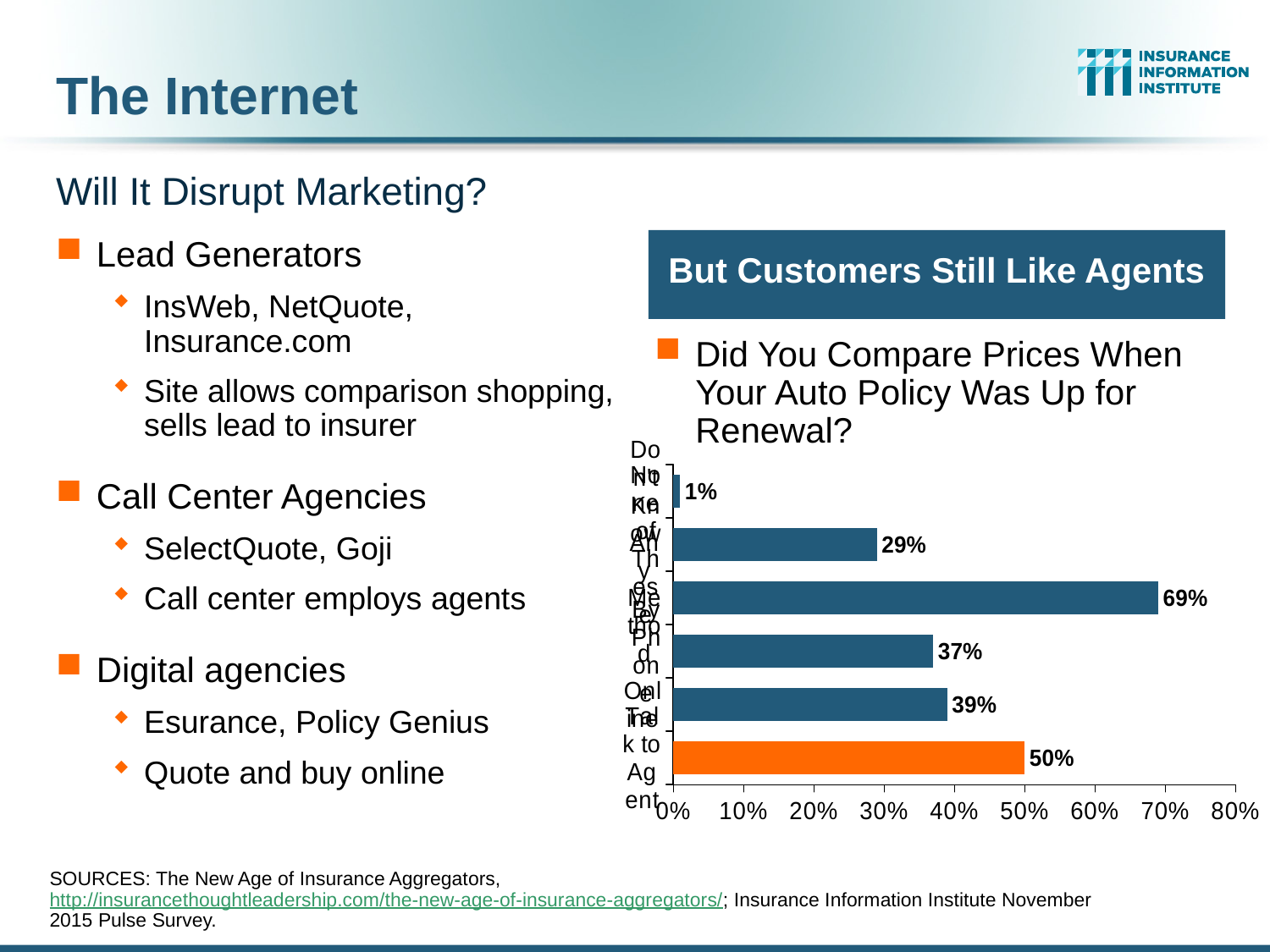
Is the value of the bottom orange bar greater or less than 40%? greater Which is larger: the bar labelled 37% or the bar labelled 39%? 39% How many bars does the chart show? 6 What is the value of the bottom (orange) bar in the chart? 50% What is the value shown on the shortest bar in the chart? 1% What is the value of the top bar in the chart? 1% What is the value shown on the longest bar in the chart? 69% What kind of chart is shown on the slide? bar chart What is the highest value shown on the x axis of the chart? 80% What colour is the bottom bar in the chart, which differs from the others? orange What is the difference between the longest bar (69%) and the bottom orange bar (50%)? 19% What is the value of the second bar from the top in the chart? 29%